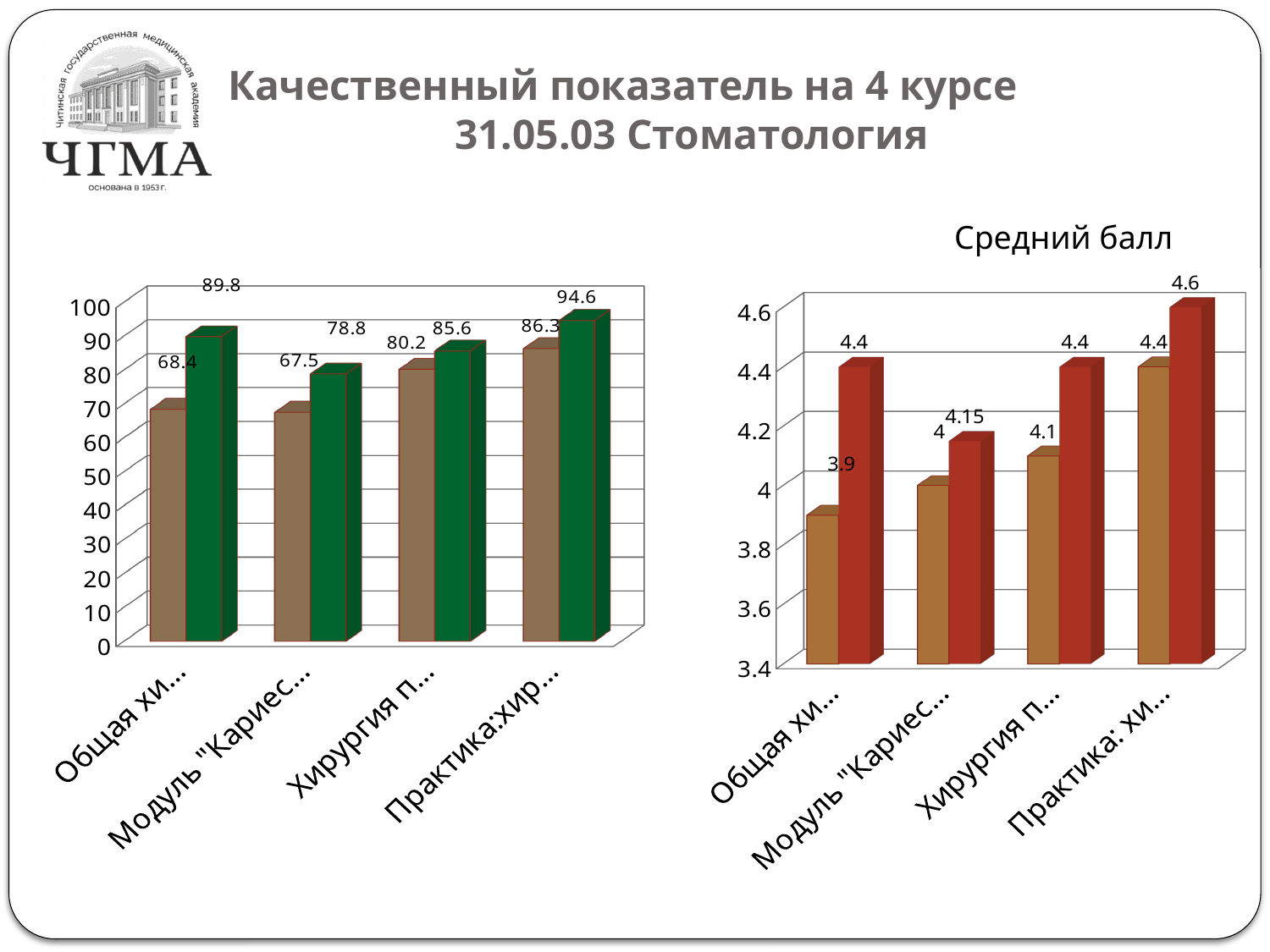
On the chart titled 'Средний балл', what is the value of the brown bar for the third category (Хирургия п...)? 4.1 What type of chart is the left chart on the slide? Bar chart On the chart titled 'Средний балл', which category has the lowest brown bar? Общая хи... (3.9) On the chart titled 'Средний балл', which category has the highest red bar? Практика: хи... (4.6) How many categories are shown on the chart titled 'Средний балл'? 4 On the left chart, what is the value of the brown bar for the fourth category (Практика:хир...)? 86.3 On the chart titled 'Средний балл', what is the value of the red bar for the second category (Модуль "Кариес...)? 4.15 On the left chart, which is larger: the brown bar for Хирургия п... or the brown bar for Практика:хир...? Практика:хир... (86.3) On the left chart, which category has the lowest brown bar? Модуль "Кариес... (67.5) On the left chart, which category has the highest green bar? Практика:хир... (94.6) On the left chart, what is the difference between the green bar and the brown bar for the first category (Общая хи...)? 21.4 On the left chart, what is the value of the green bar for the first category (Общая хи...)? 89.8